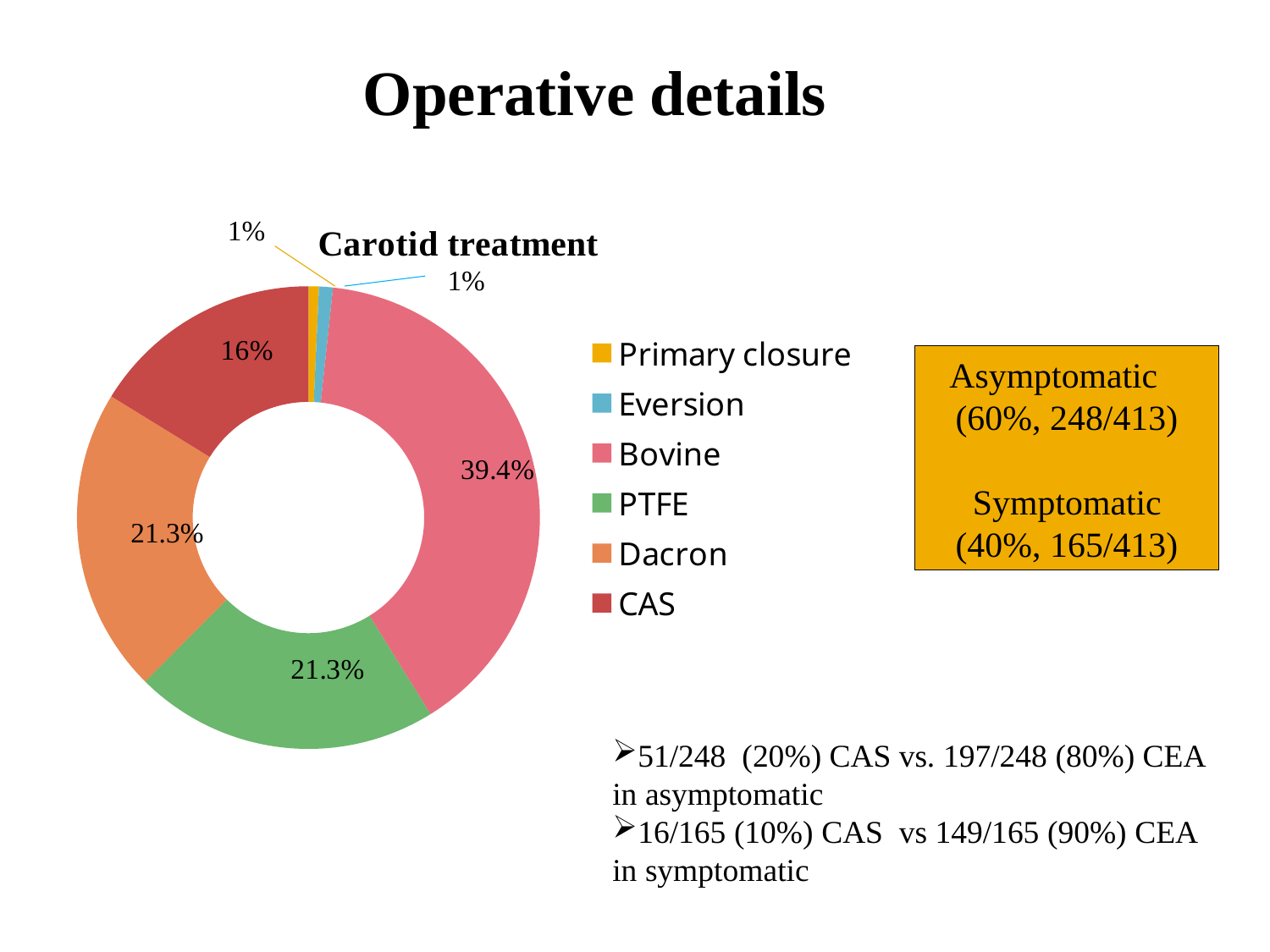
What kind of chart is shown under the title "Carotid treatment"? doughnut chart Which category has the largest share in the Carotid treatment chart? Bovine What percentage of the Carotid treatment chart is Eversion? 1% Which is larger in the Carotid treatment chart, Bovine or CAS? Bovine How many categories does the Carotid treatment chart show? 6 What is the title of the chart? Carotid treatment What is the difference between the Bovine share and the CAS share in the Carotid treatment chart? 23.4% Which colour represents Dacron in the Carotid treatment chart? orange What percentage of the Carotid treatment chart is Bovine? 39.4% What percentage of the Carotid treatment chart is PTFE? 21.3% What is the difference between the Bovine share and the PTFE share in the Carotid treatment chart? 18.1% What percentage of the Carotid treatment chart is CAS? 16%